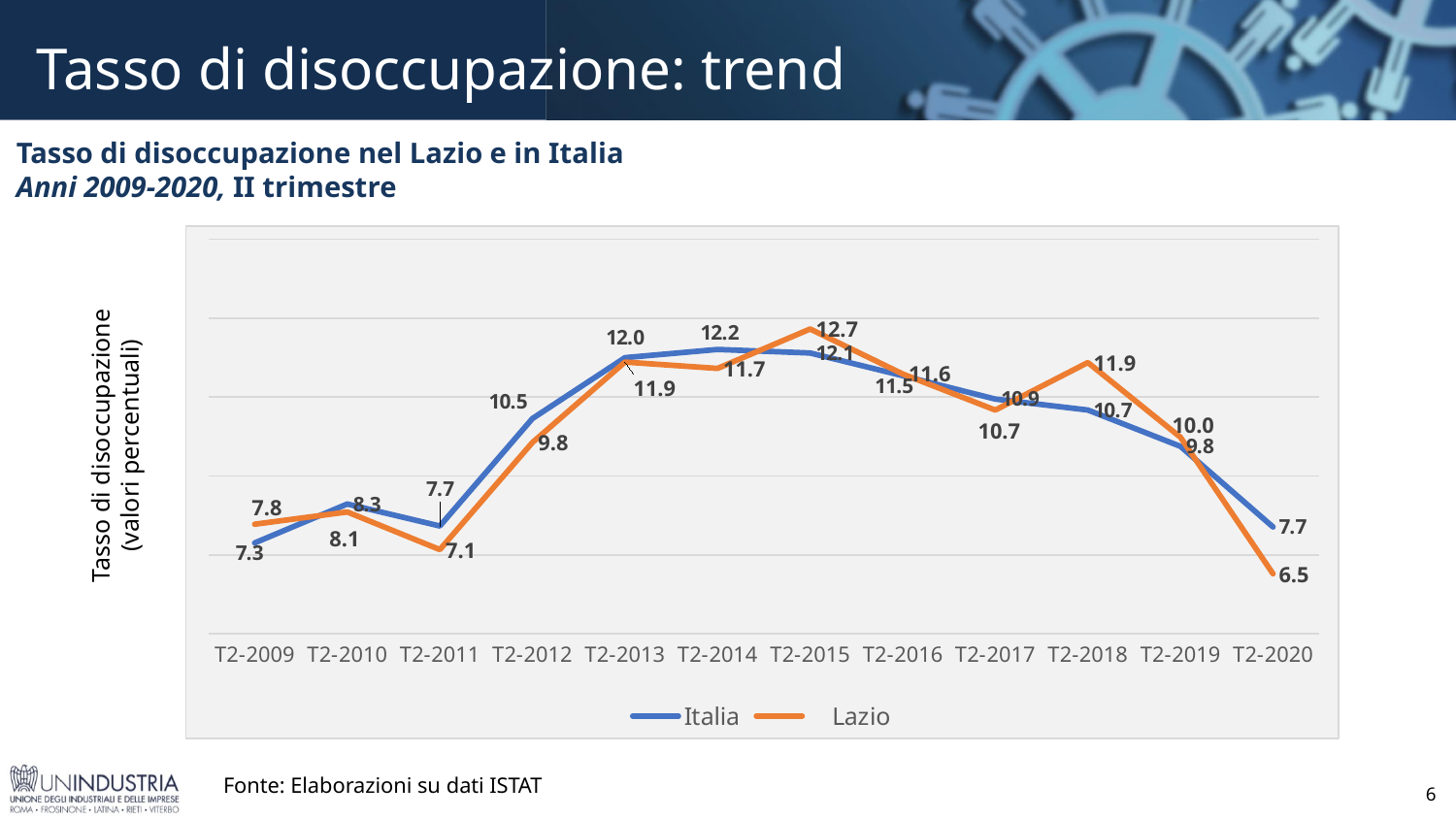
What is the unemployment rate for Lazio in T2-2020? 6.5 Which colour is used for the Lazio series? orange How many series does the legend list? 2 How many time points are plotted along the x axis? 12 What is the unemployment rate for Italia in T2-2014? 12.2 What is the difference between the Italia and Lazio values in T2-2020? 1.2 In which period does the Lazio series reach its highest value? T2-2015 What is the unemployment rate for Lazio in T2-2018? 11.9 In which period does the Italia series reach its lowest value? T2-2009 In T2-2018, which series has the higher value, Italia or Lazio? Lazio Does the Lazio series rise or fall between T2-2018 and T2-2020? fall What type of chart is shown on the slide? line chart